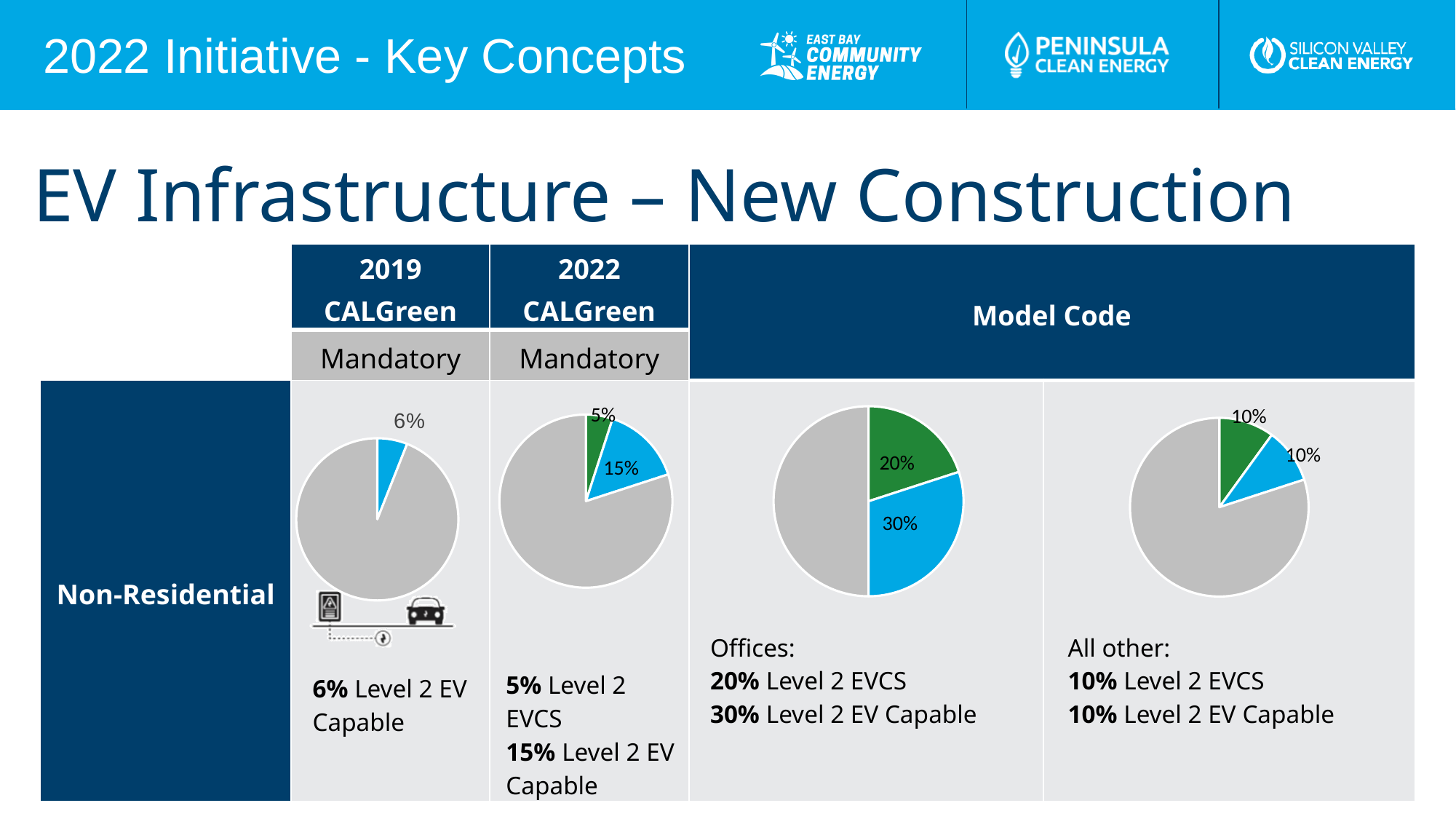
In the 2022 CALGreen Mandatory pie chart, which is larger: the Level 2 EVCS slice or the Level 2 EV Capable slice? Level 2 EV Capable In the 2019 CALGreen Mandatory pie chart, what percentage is labelled for Level 2 EV Capable? 6% In the 2022 CALGreen Mandatory pie chart, what is the combined percentage of the Level 2 EVCS and Level 2 EV Capable slices? 20% In the 2022 CALGreen Mandatory pie chart, what percentage is shown for Level 2 EVCS? 5% In the Model Code All other pie chart, what percentage is shown for Level 2 EVCS? 10% In the Model Code Offices pie chart, what is the difference between the Level 2 EV Capable percentage and the Level 2 EVCS percentage? 10% In the Model Code Offices pie chart, what percentage is shown for Level 2 EV Capable? 30% In the Model Code Offices pie chart, what percentage is shown for Level 2 EVCS? 20% How many pie charts are shown on the slide? 4 In the 2022 CALGreen Mandatory pie chart, what percentage is shown for Level 2 EV Capable? 15% What type of chart is used in the Model Code Offices column? Pie chart In the Model Code Offices pie chart, what colour is the 30% Level 2 EV Capable slice? Blue